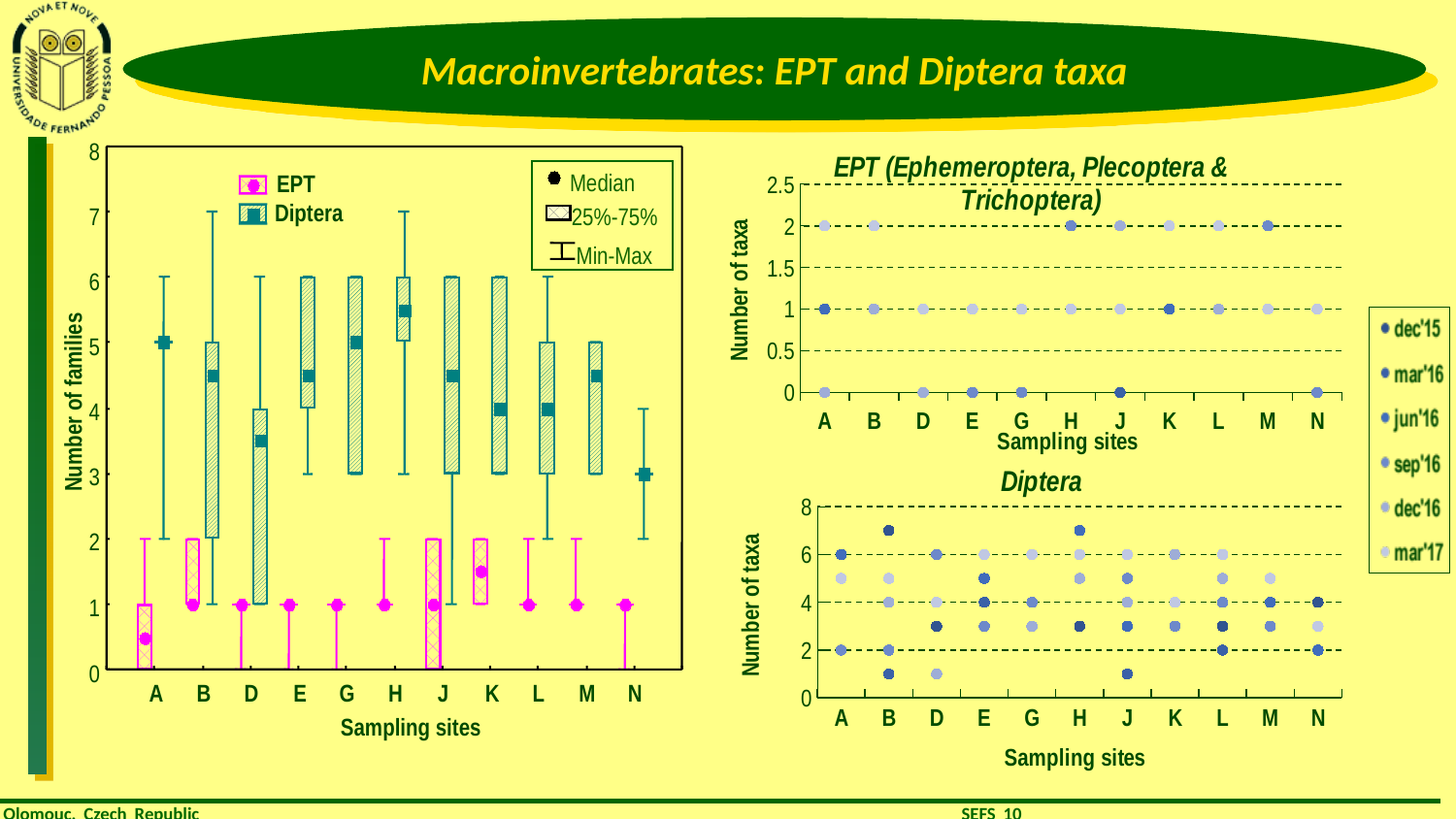
In the EPT (Ephemeroptera, Plecoptera & Trichoptera) chart, what is the highest number of taxa recorded at any site? 2 In the left chart, what is the median number of Diptera families at sampling site A? 5 What is the y-axis label of the Diptera chart on the right? Number of taxa How many sampling dates does the legend on the right side of the slide list? 6 In the left chart, what is the median number of Diptera families at sampling site N? 3 How many series does the legend of the left chart list (EPT/Diptera)? 2 How many sampling sites are shown on the x axis of the left chart? 11 What kind of chart is the left chart showing number of families by sampling site? Box plot In the left chart, is the median number of Diptera families at site H greater or less than 5? greater In the left chart, which series has the higher median at site A, EPT or Diptera? Diptera In the left chart, is the median number of Diptera families at site B greater or less than 4? greater